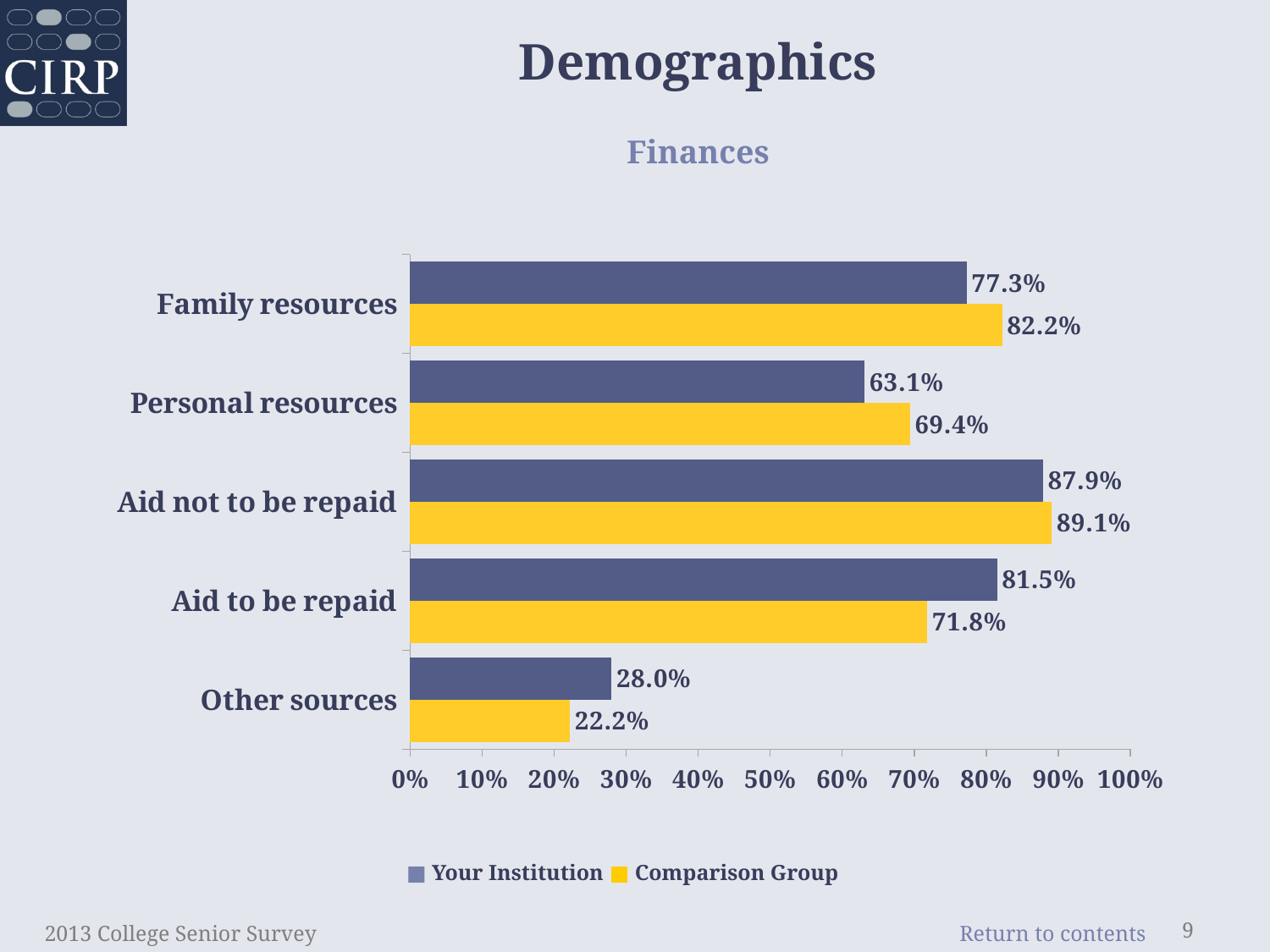
What is the value for Comparison Group for Other sources? 22.2% What is the difference between Your Institution and Comparison Group for Aid to be repaid? 9.7% What is the difference between the Comparison Group and Your Institution values for Personal resources? 6.3% Which category has the highest value for Your Institution? Aid not to be repaid Which category has the lowest value for Comparison Group? Other sources What is the value for Comparison Group for Aid to be repaid? 71.8% What kind of chart is shown on the slide? bar chart What is the value for Your Institution for Family resources? 77.3% For Family resources, which is larger: Your Institution or Comparison Group? Comparison Group How many categories are shown on the chart? 5 Is the value for Your Institution for Personal resources greater or less than 70%? less How many series does the legend list? 2